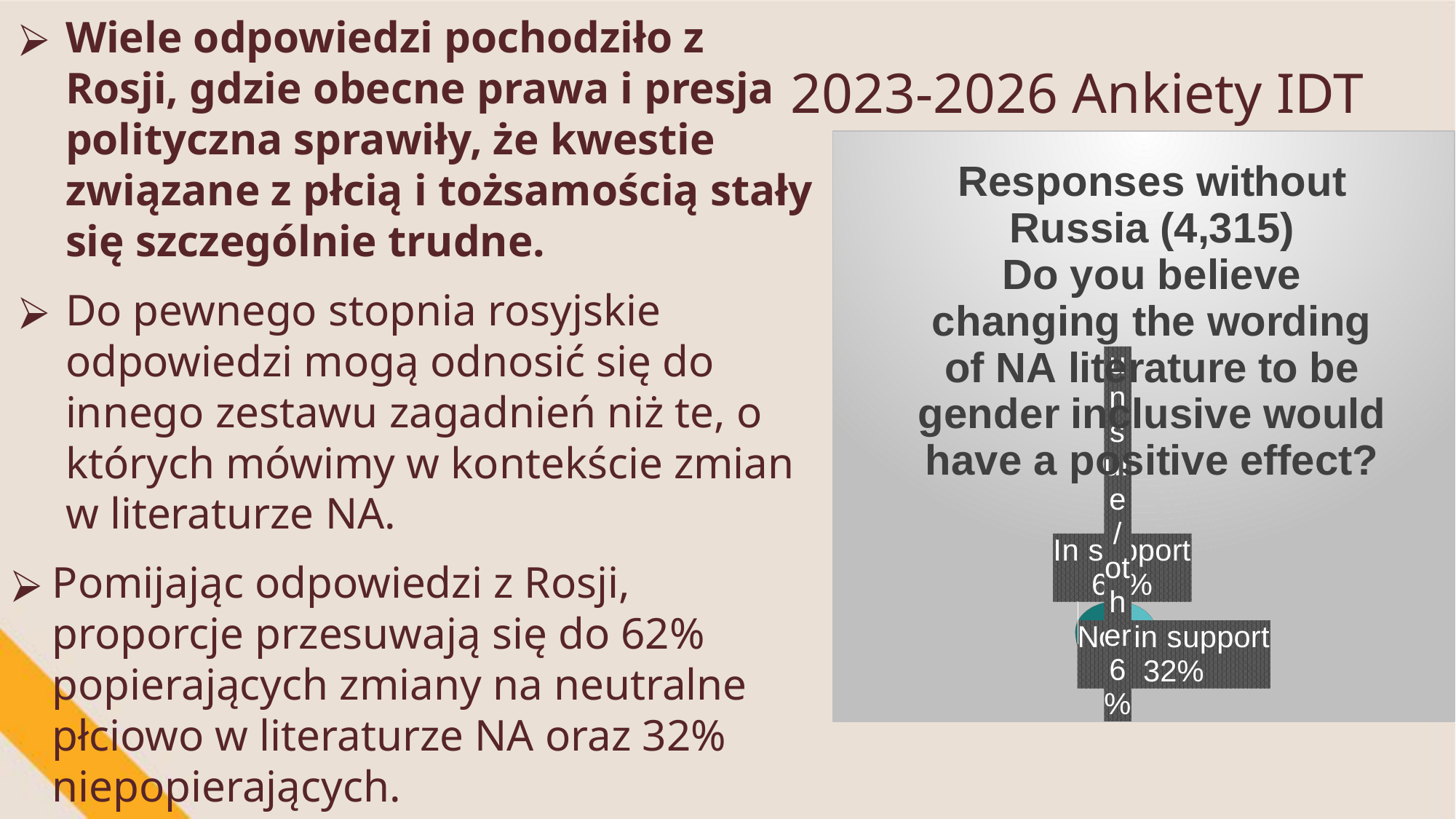
How many response categories does the chart show? 3 What question does the chart title say the responses are about? Do you believe changing the wording of NA literature to be gender inclusive would have a positive effect? Which response category has the largest share in the chart? In support By how many percentage points does "In support" exceed "Not in support" in the chart? 30 percentage points What kind of chart is shown on the slide? Pie chart Which response category has the smallest share in the chart? Unsure/other What percentage of responses are labelled "Not in support" in the chart? 32% Which is larger in the chart, the share "In support" or the share "Not in support"? In support According to the chart title, how many responses are included when Russia is excluded? 4,315 What percentage of responses are labelled "In support" in the chart? 62%